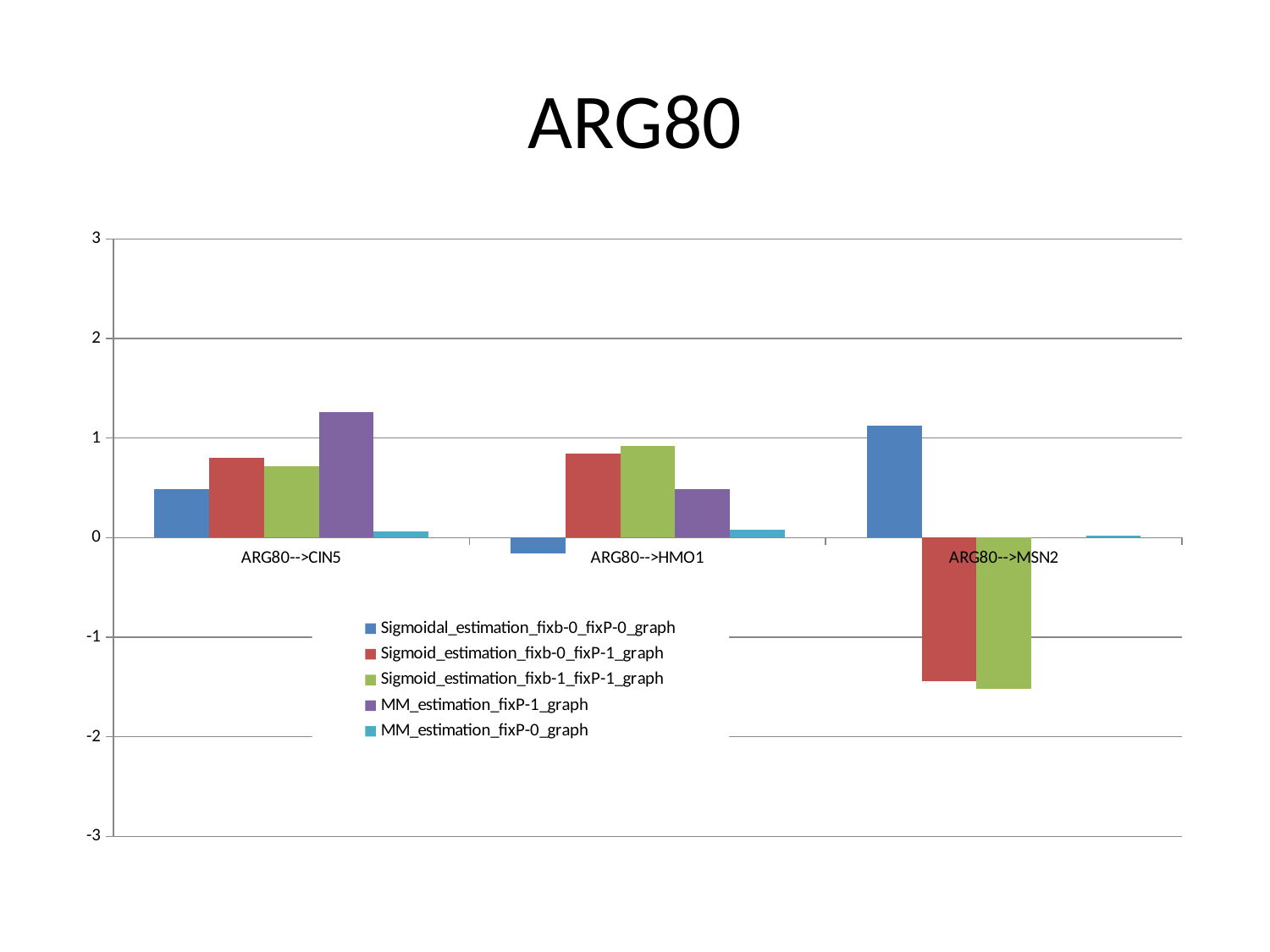
Is the value of Sigmoid_estimation_fixb-1_fixP-1_graph for ARG80-->MSN2 greater or less than -1? less How many series does the legend list? 5 What is the title of the slide? ARG80 Is the value of Sigmoid_estimation_fixb-0_fixP-1_graph for ARG80-->MSN2 greater or less than -1? less Is the value of MM_estimation_fixP-1_graph for ARG80-->CIN5 greater or less than 1? greater Is the value of Sigmoidal_estimation_fixb-0_fixP-0_graph larger for ARG80-->CIN5 or for ARG80-->MSN2? ARG80-->MSN2 For ARG80-->CIN5, which series has the highest value? MM_estimation_fixP-1_graph Which series is shown in purple in the legend? MM_estimation_fixP-1_graph How many categories are shown on the x axis of the chart? 3 For ARG80-->HMO1, which series has the lowest value? Sigmoidal_estimation_fixb-0_fixP-0_graph What kind of chart is shown on the slide? bar chart